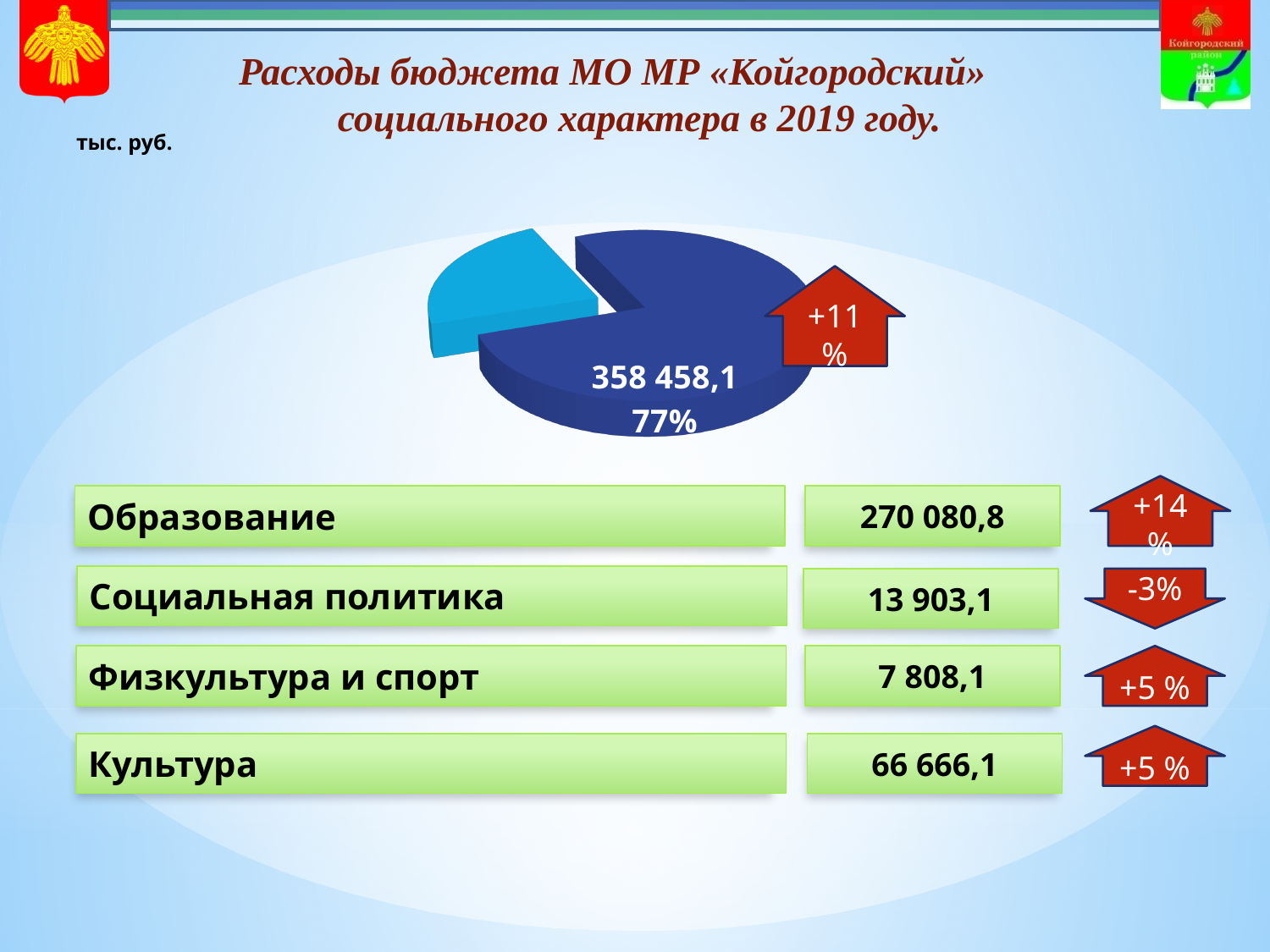
What percentage change is shown in the red arrow next to the pie chart? +11 % What kind of chart is shown on the slide? pie chart What value is printed on the dark blue slice of the pie chart? 358 458,1 How many slices does the pie chart have? 2 Which slice of the pie chart is the smallest? the light blue slice Which slice of the pie chart is larger, the dark blue one or the light blue one? the dark blue one What is the title of the slide containing the pie chart? Расходы бюджета МО МР «Койгородский» социального характера в 2019 году. What share of the pie does the dark blue slice represent? 77% Which slice of the pie chart is the largest? the dark blue slice (358 458,1)